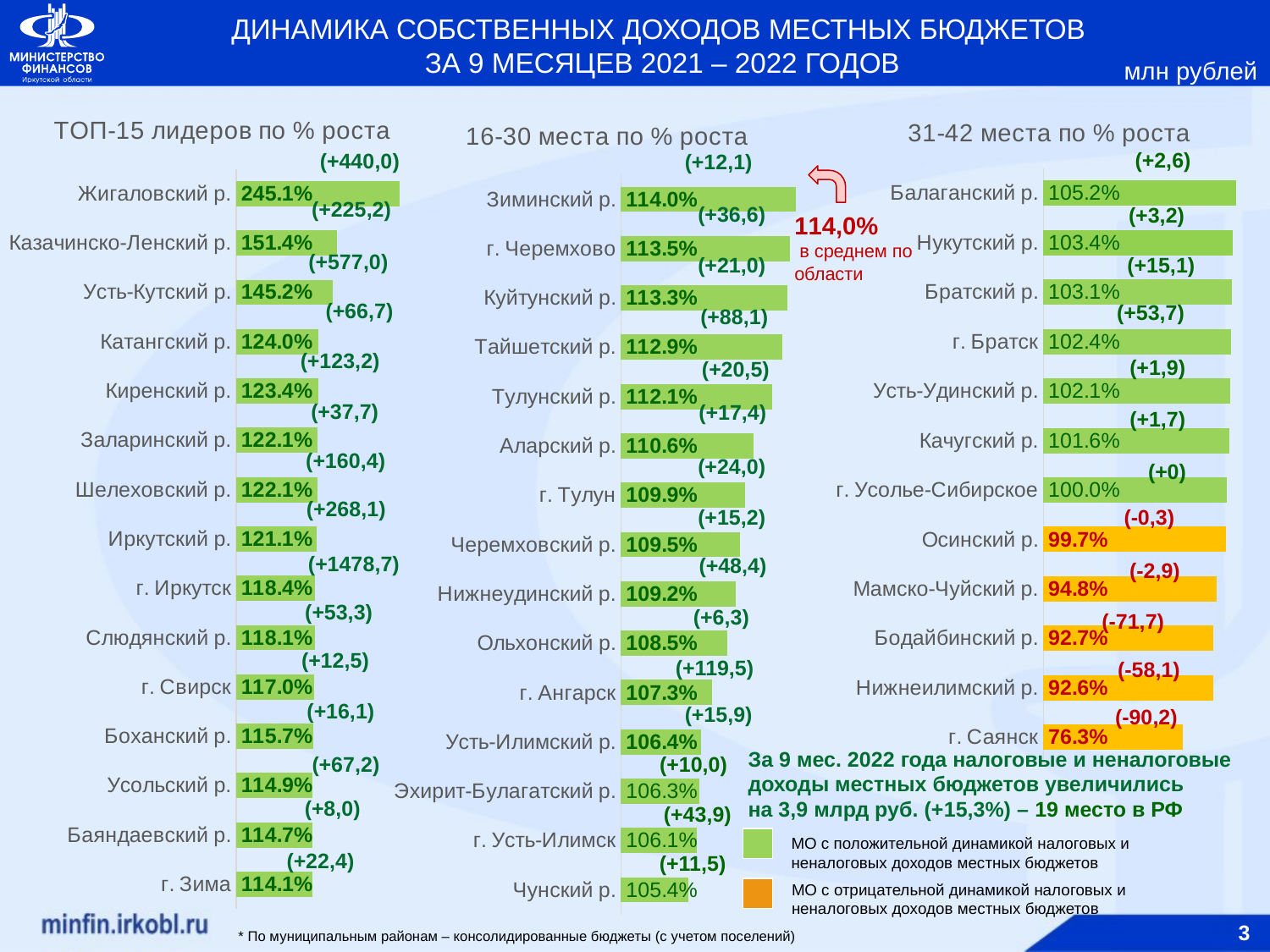
In the chart 'ТОП-15 лидеров по % роста', what is the value shown in parentheses above the bar for г. Иркутск? (+1478,7) What kind of chart is used on this slide to show the growth percentages? Bar chart In the chart '31-42 места по % роста', what is the value for г. Саянск? 76.3% In the chart '31-42 места по % роста', which is larger, the value for Братский р. or the value for г. Братск? Братский р. In the chart 'ТОП-15 лидеров по % роста', what is the difference in percentage points between Жигаловский р. and Казачинско-Ленский р.? 93.7 In the chart '16-30 места по % роста', how many categories are plotted? 15 In the chart 'ТОП-15 лидеров по % роста', which category has the highest value? Жигаловский р. In the chart 'ТОП-15 лидеров по % роста', what is the value for Жигаловский р.? 245.1% In the chart '16-30 места по % роста', which category has the lowest value? Чунский р. In the chart '16-30 места по % роста', what is the value for Тайшетский р.? 112.9% In the chart '31-42 места по % роста', how many categories are plotted? 12 According to the legend, what does an orange bar indicate? МО с отрицательной динамикой налоговых и неналоговых доходов местных бюджетов